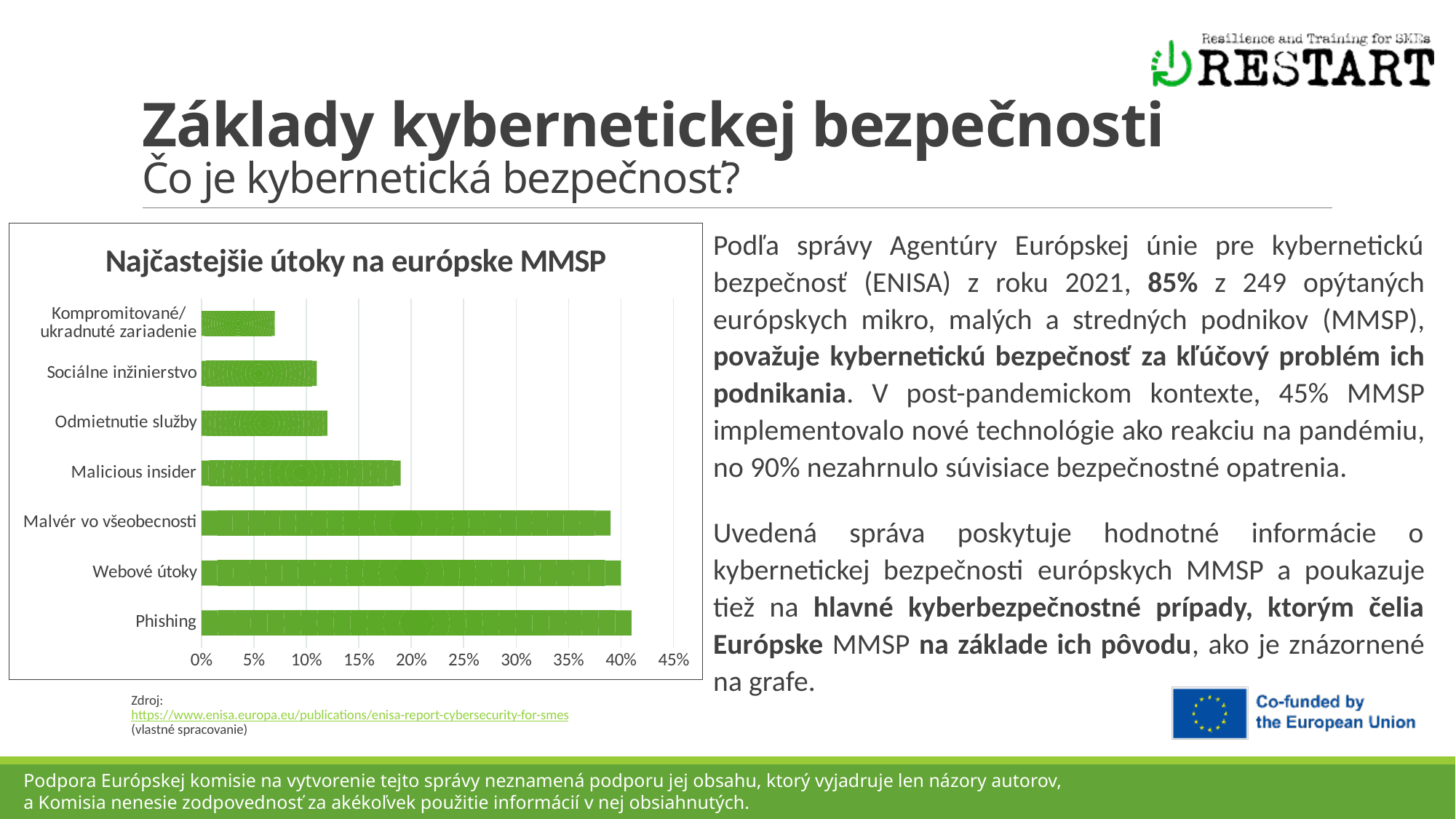
Is the value for Kompromitované/ukradnuté zariadenie greater or less than 10%? less What kind of chart is shown on the slide? bar chart How many categories of attacks does the chart show? 7 Is the value for Odmietnutie služby greater or less than 15%? less Which category has the lowest value in the chart? Kompromitované/ukradnuté zariadenie What is the highest value shown on the chart's horizontal axis? 45% Is the value for Malicious insider greater or less than 15%? greater What is the title of the chart? Najčastejšie útoky na európske MMSP Which is larger, the value for Webové útoky or the value for Sociálne inžinierstvo? Webové útoky Which is larger, the value for Malicious insider or the value for Odmietnutie služby? Malicious insider